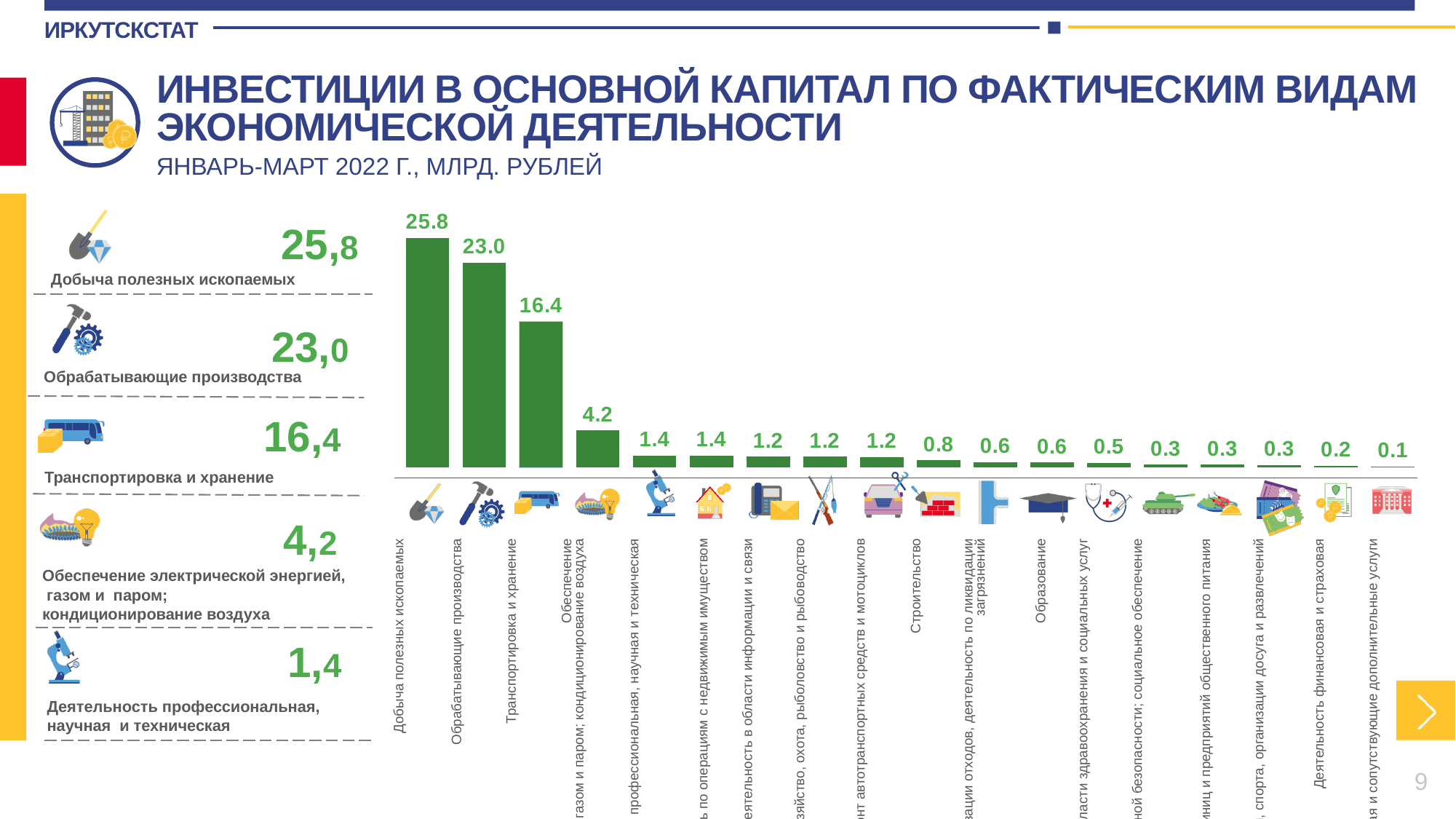
What is the value for Добыча полезных ископаемых in the bar chart? 25.8 Which category has the highest value in the bar chart? Добыча полезных ископаемых How many bars are plotted in the bar chart? 18 Do the values in the bar chart rise or fall from left to right? fall What is the value for Обрабатывающие производства in the bar chart? 23.0 Which is larger: the value for Транспортировка и хранение or the value for Обрабатывающие производства? Обрабатывающие производства What is the value for Деятельность финансовая и страховая in the bar chart? 0.2 What is the difference between the values for Добыча полезных ископаемых and Обрабатывающие производства? 2.8 What is the value for Строительство in the bar chart? 0.8 What type of chart is shown on the slide? bar chart What is the value for Транспортировка и хранение in the bar chart? 16.4 What is the value for Образование in the bar chart? 0.6